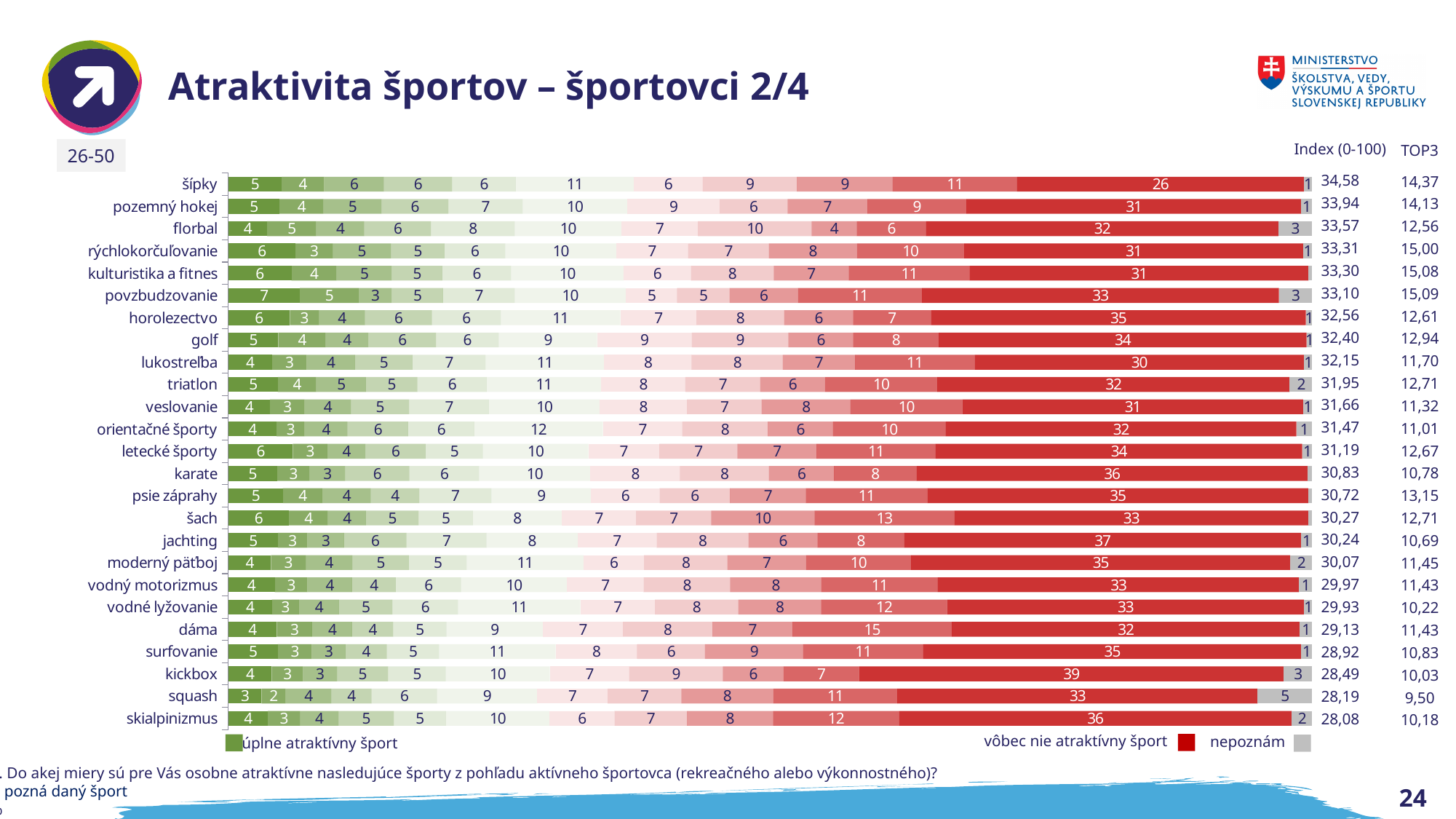
Do the Index (0-100) values rise or fall going down the list from šípky to skialpinizmus? fall How many sports are listed in the chart? 25 What kind of chart is shown on the slide? bar chart What is the Index (0-100) value for šípky? 34,58 Which sport has the highest Index (0-100) value? šípky What is the TOP3 value for povzbudzovanie? 15,09 What is the difference between the Index values of šípky and skialpinizmus? 6,50 Which sport has the lowest Index (0-100) value? skialpinizmus What is the value of the 'vôbec nie atraktívny šport' (dark red) segment for kickbox? 39 Which sport has the lowest TOP3 value? squash What is the 'nepoznám' (grey) segment value for squash? 5 Which has a larger 'vôbec nie atraktívny šport' (dark red) segment, jachting or karate? jachting